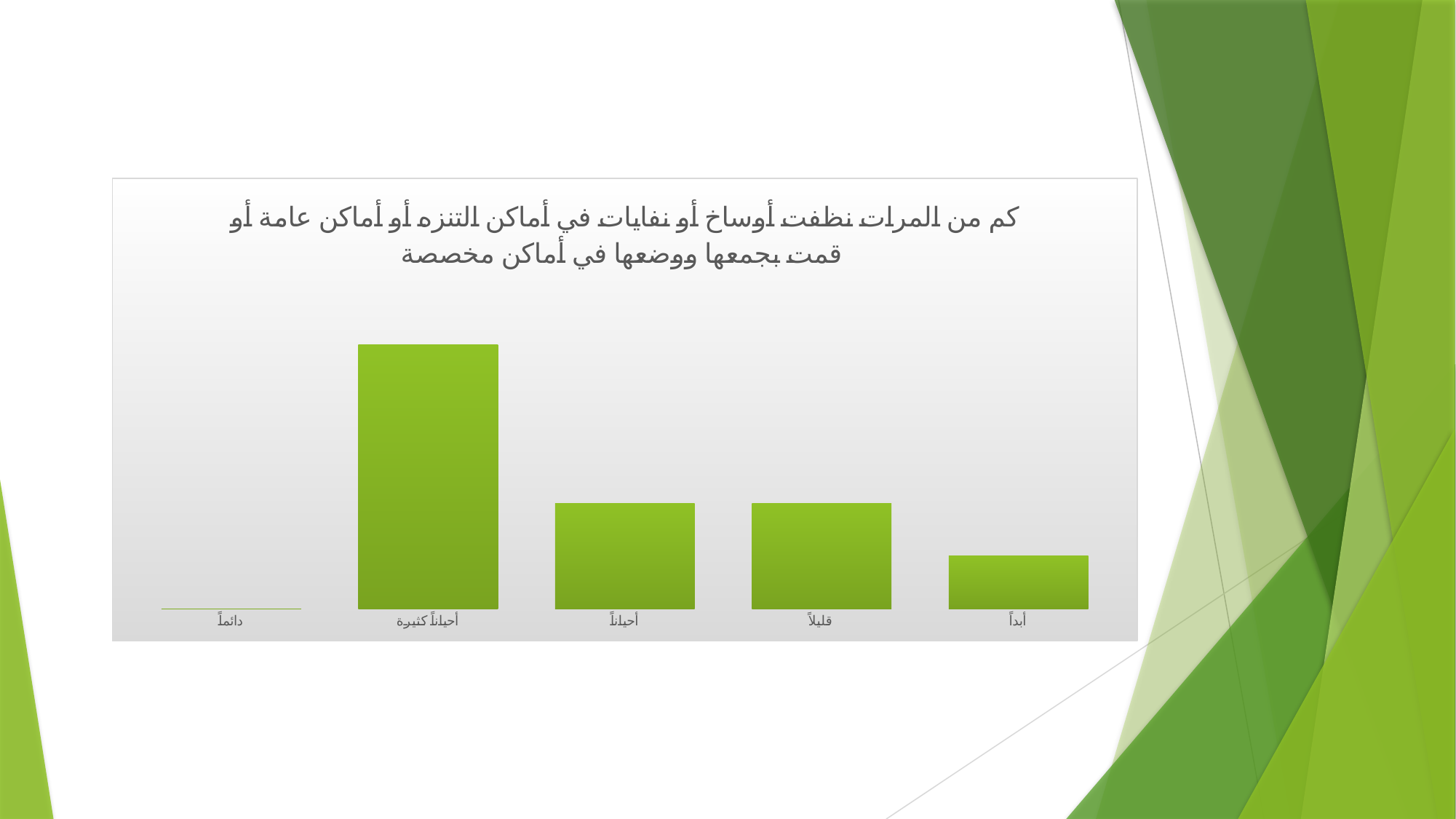
What is the title of the chart? كم من المرات نظفت أوساخ أو نفايات في أماكن التنزه أو أماكن عامة أو قمت بجمعها ووضعها في أماكن مخصصة What kind of chart is shown on the slide? bar chart Which is larger, the bar for أبداً or the bar for دائماً? أبداً Which category has the highest bar in the chart? أحياناً كثيرة How many categories are shown on the x axis of the chart? 5 Which category label appears at the far right of the x axis? أبداً Which category label appears at the far left of the x axis? دائماً What colour are the bars in the chart? green Which is larger, the bar for أحياناً كثيرة or the bar for أحياناً? أحياناً كثيرة Which is larger, the bar for قليلاً or the bar for أبداً? قليلاً Which category has the lowest bar in the chart? دائماً